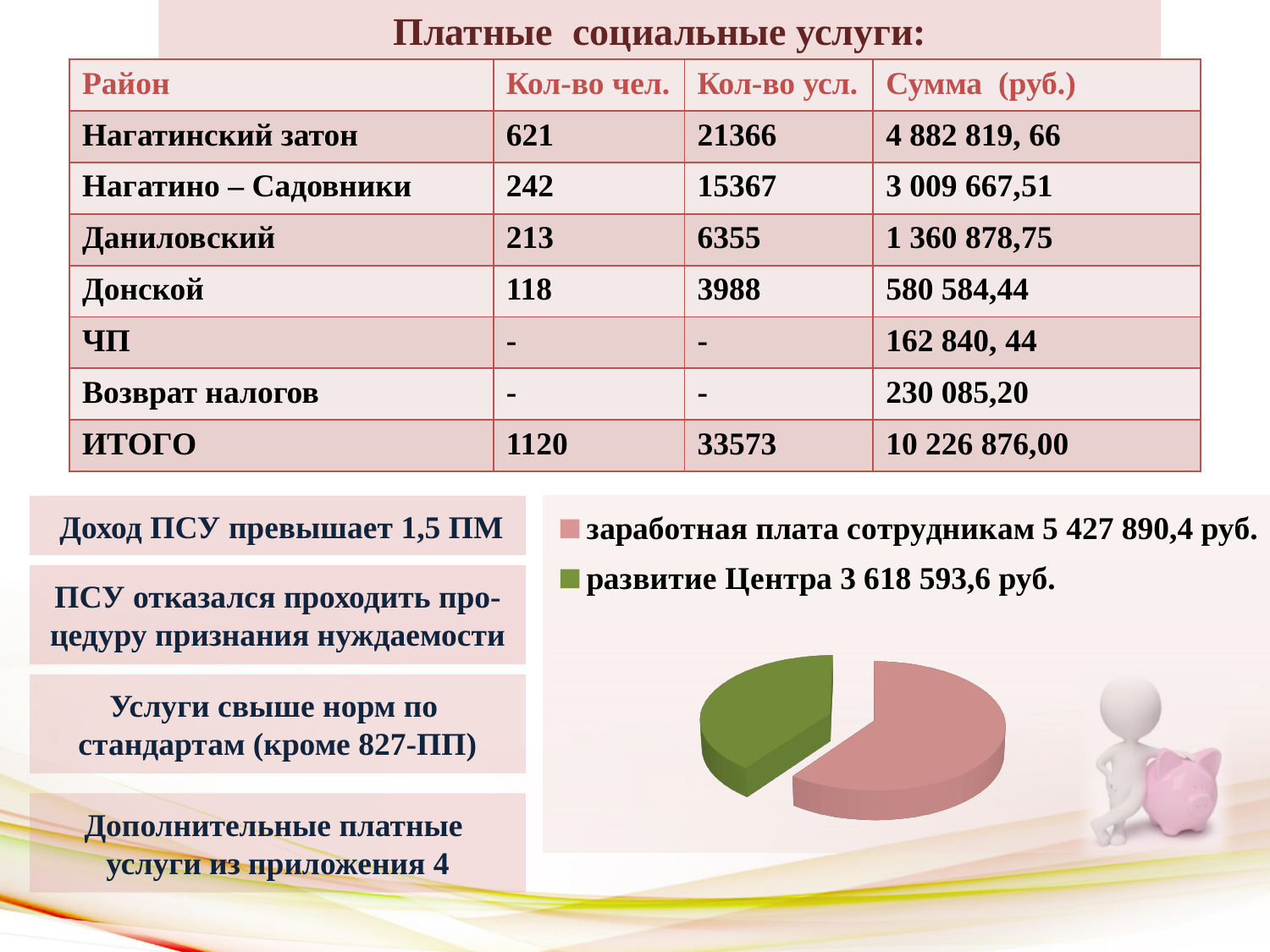
According to the pie chart legend, what is the value for развитие Центра? 3 618 593,6 руб. Which slice of the pie chart is the smallest? развитие Центра How many entries does the pie chart's legend list? 2 What colour is the развитие Центра slice in the pie chart? green How many slices does the pie chart have? 2 What is the difference between the values for заработная плата сотрудникам and развитие Центра in the pie chart? 1 809 296,8 руб. Which slice of the pie chart is the largest? заработная плата сотрудникам Which is larger in the pie chart: заработная плата сотрудникам or развитие Центра? заработная плата сотрудникам What kind of chart is shown on the slide? pie chart What share of the pie chart does заработная плата сотрудникам represent? 60% What is the total of the two values shown in the pie chart legend? 9 046 484 руб. According to the pie chart legend, what is the value for заработная плата сотрудникам? 5 427 890,4 руб.